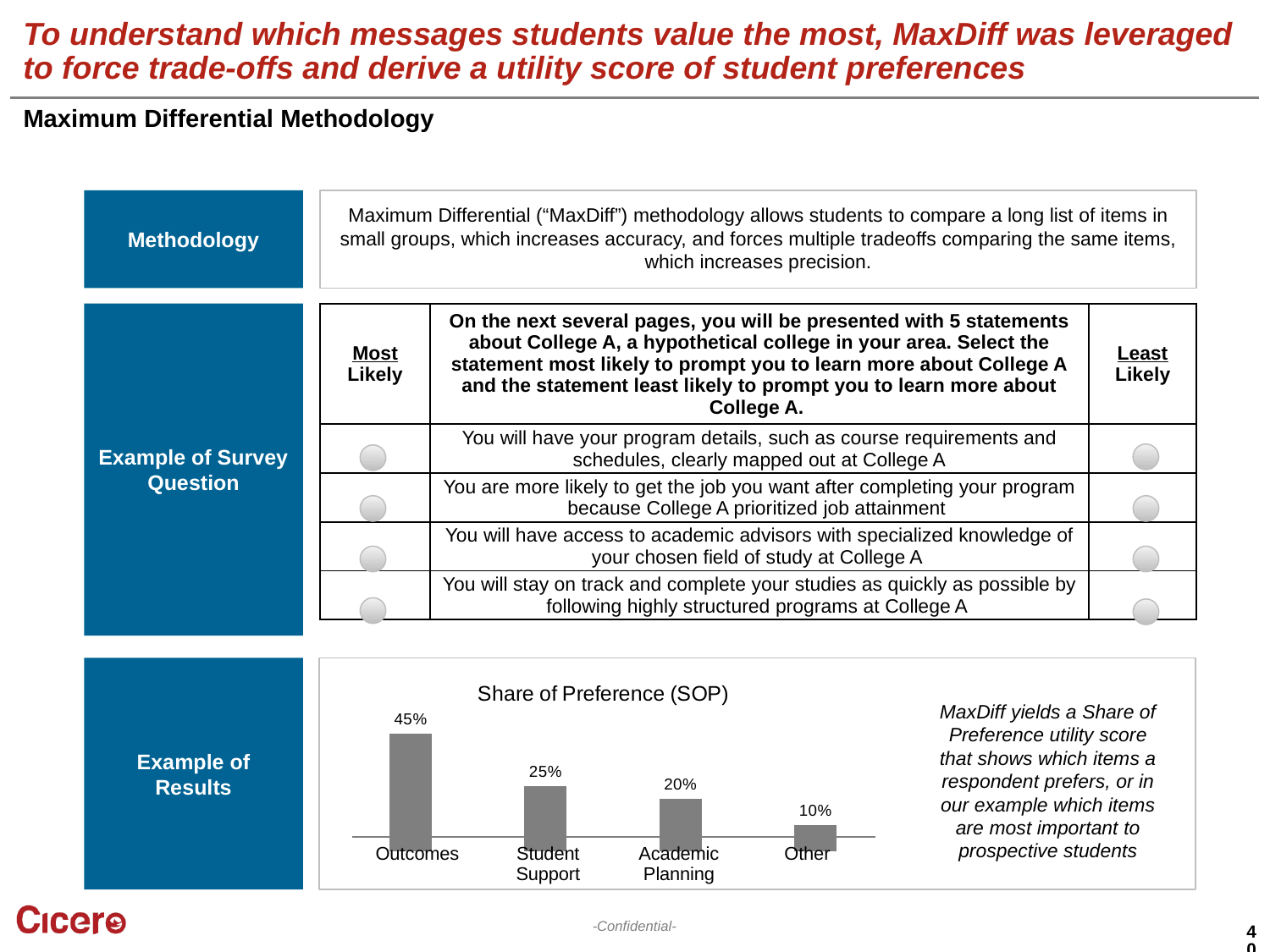
What is the difference between the Share of Preference for Outcomes and Student Support? 20% Which has a larger Share of Preference, Student Support or Academic Planning? Student Support How many categories are shown in the Share of Preference chart? 4 What is the difference between the Share of Preference for Academic Planning and Other? 10% What is the Share of Preference value for Student Support? 25% Which category has the lowest Share of Preference? Other What kind of chart is the Share of Preference (SOP) chart? Bar chart Which category has the highest Share of Preference? Outcomes What is the Share of Preference value for Academic Planning? 20% What is the Share of Preference value for Outcomes? 45% Do the values in the Share of Preference chart rise or fall from left to right? Fall What is the Share of Preference value for Other? 10%